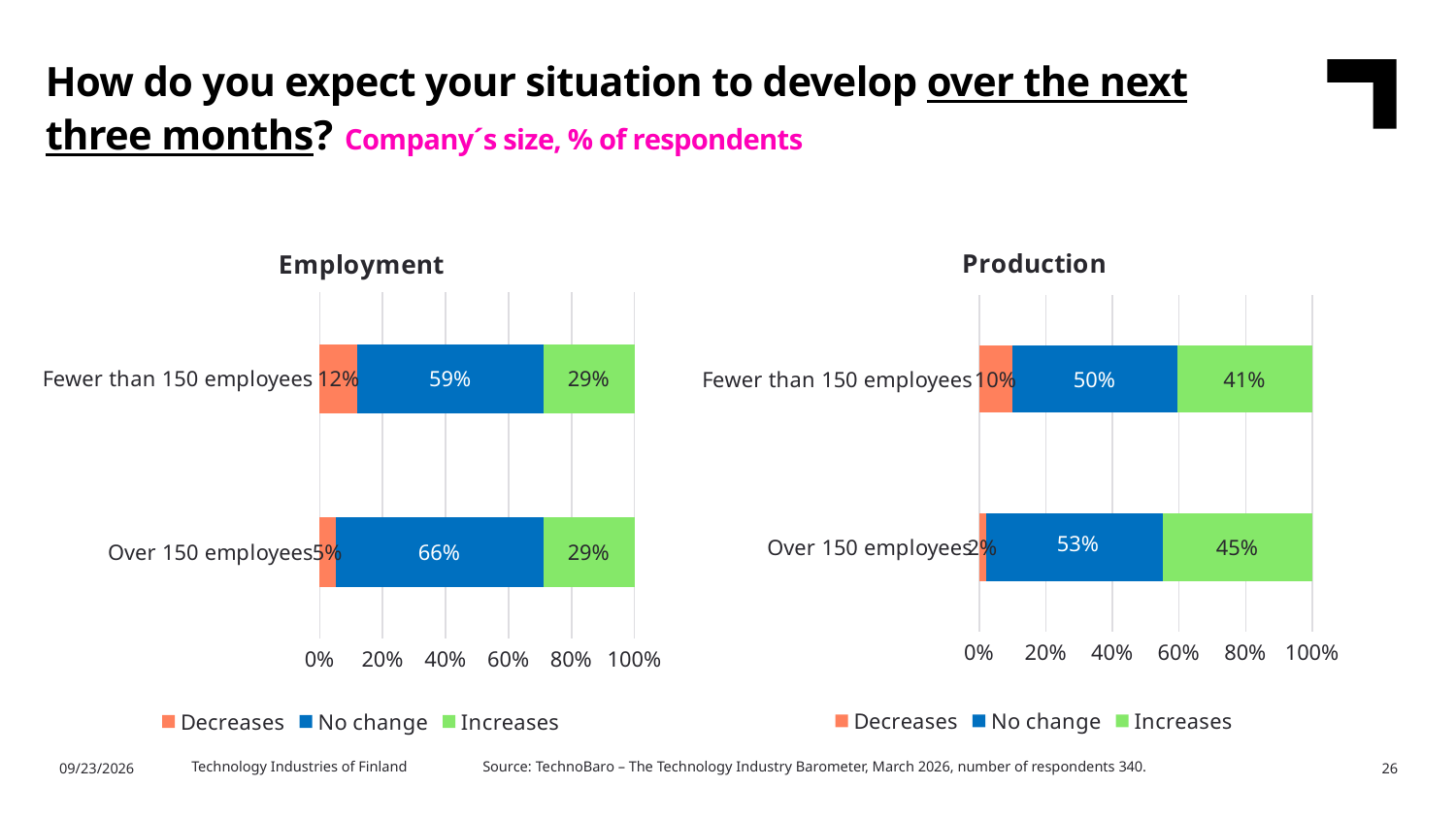
How many series does the legend of the Employment chart list? 3 In the Employment chart, what percentage of respondents from companies with fewer than 150 employees expect no change? 59% In the Employment chart, what percentage of respondents from companies with over 150 employees expect decreases? 5% In the Production chart, what percentage of respondents from companies with fewer than 150 employees expect decreases? 10% Which colour represents 'Increases' in the legend of the Production chart? Green In the Production chart, what is the difference between the 'No change' values for the two company size groups? 3% In the Production chart, what percentage of respondents from companies with over 150 employees expect increases? 45% In the Employment chart, what is the total of the 'Decreases' and 'No change' segments for companies with fewer than 150 employees? 71% In the Production chart, which company size group has the larger 'Increases' share? Over 150 employees In the Employment chart, which company size group has the larger 'No change' share? Over 150 employees How many categories are shown on the y axis of the Production chart? 2 What kind of chart is the Employment chart? Stacked bar chart